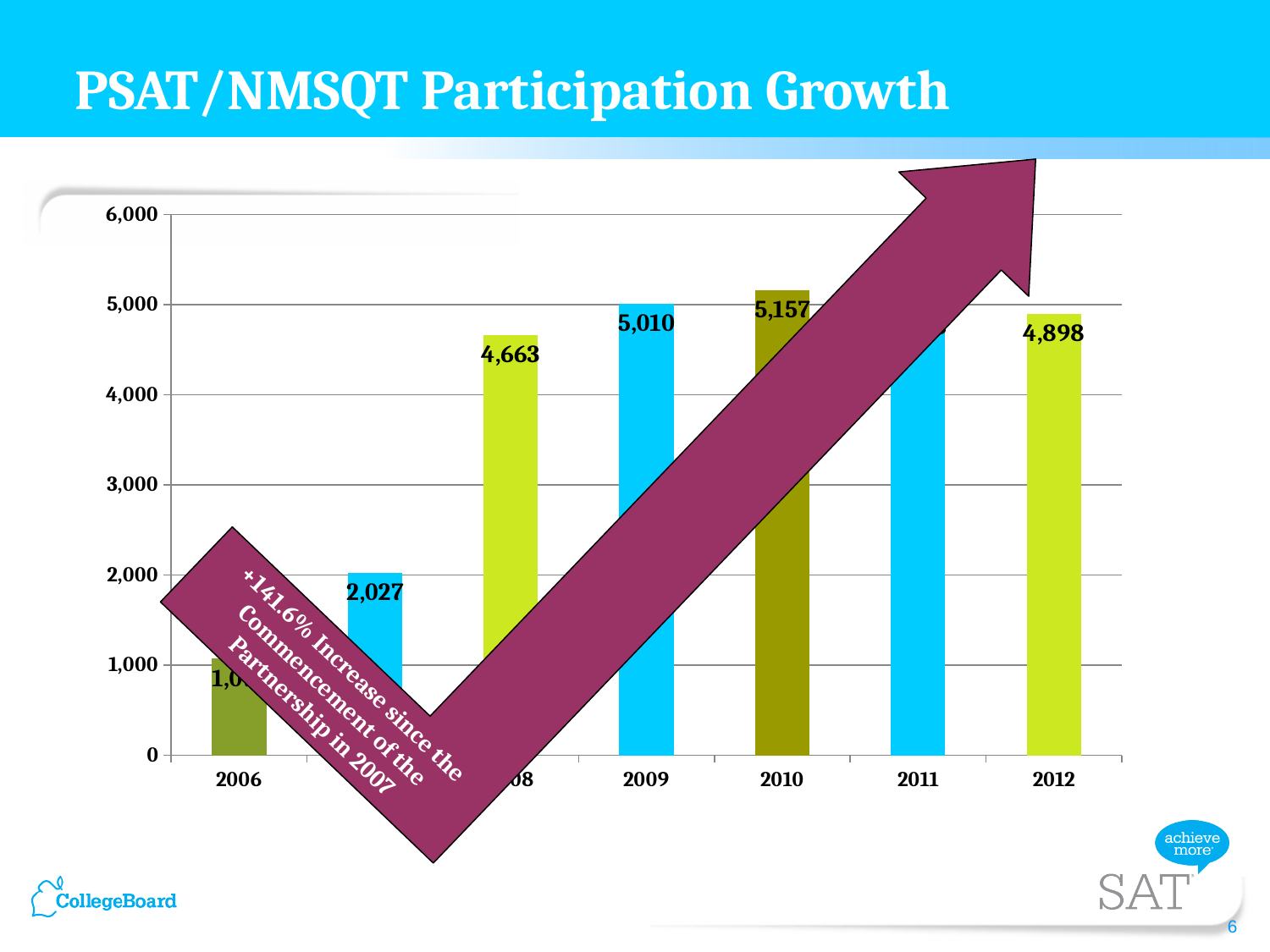
Is the value for 2011 greater or less than 4,000? greater What is the value for 2009? 5,010 What kind of chart is shown on the slide? bar chart Which year has the highest value? 2010 What is the value for 2008? 4,663 How many years are shown on the x axis? 7 What is the title of the slide? PSAT/NMSQT Participation Growth What is the difference between the values for 2010 and 2009? 147 Which is larger, the value for 2012 or the value for 2008? 2012 Which year has the lowest value? 2006 What is the value for 2010? 5,157 What is the value for 2012? 4,898